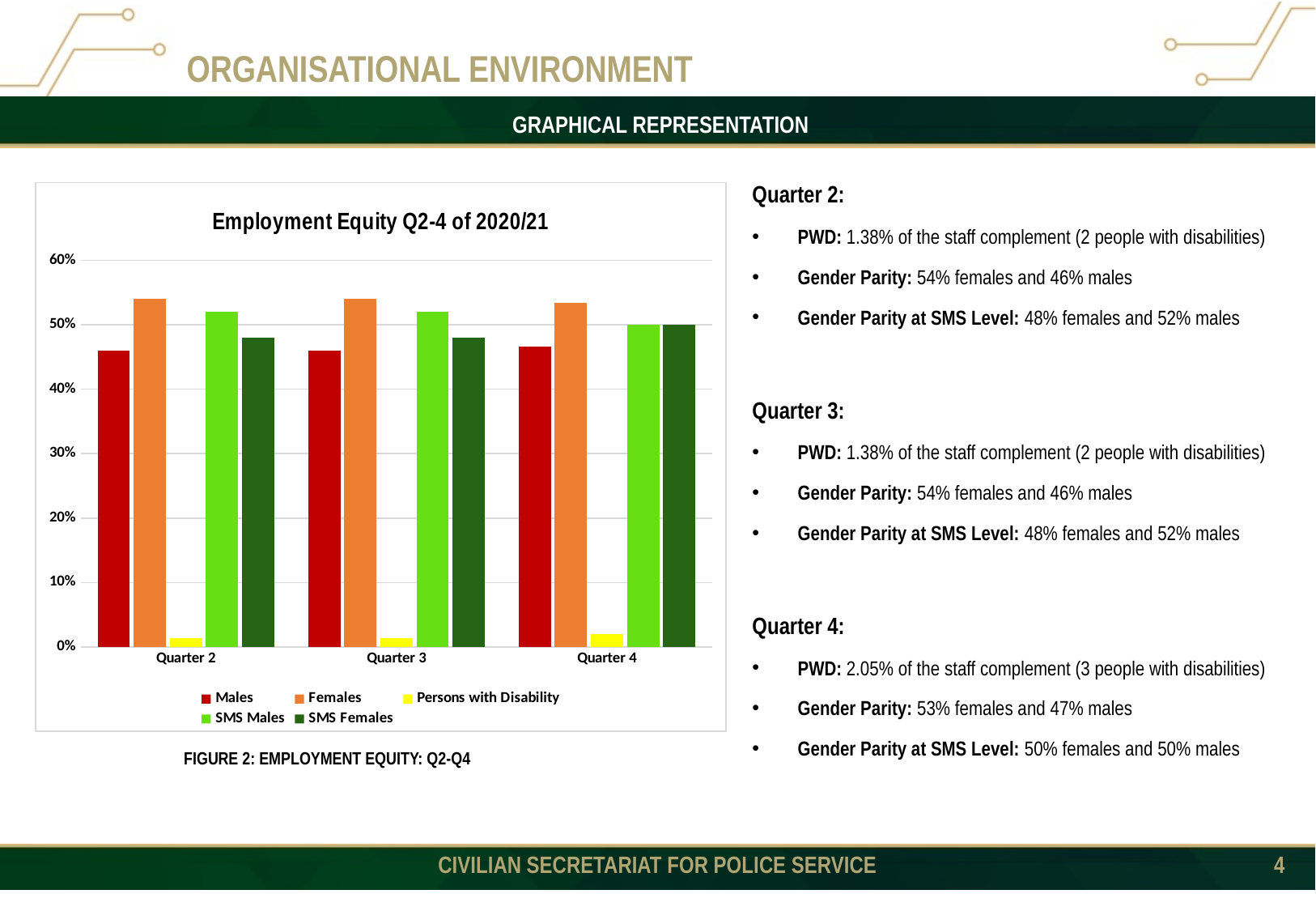
In Quarter 2, which is larger: SMS Males or SMS Females? SMS Males Is the value for Persons with Disability in Quarter 4 greater or less than 10%? less Which series has the lowest value in Quarter 3? Persons with Disability What is the value for SMS Males in Quarter 4? 50% Is the value for Females in Quarter 3 greater or less than 50%? greater Which series has the highest value in Quarter 2? Females How many series does the chart legend list? 5 What type of chart is shown on the slide? Bar chart How many quarters are shown on the x axis of the chart? 3 What is the value for SMS Females in Quarter 4? 50% What is the title of the chart? Employment Equity Q2-4 of 2020/21 Is the value for Males in Quarter 2 greater or less than 50%? less